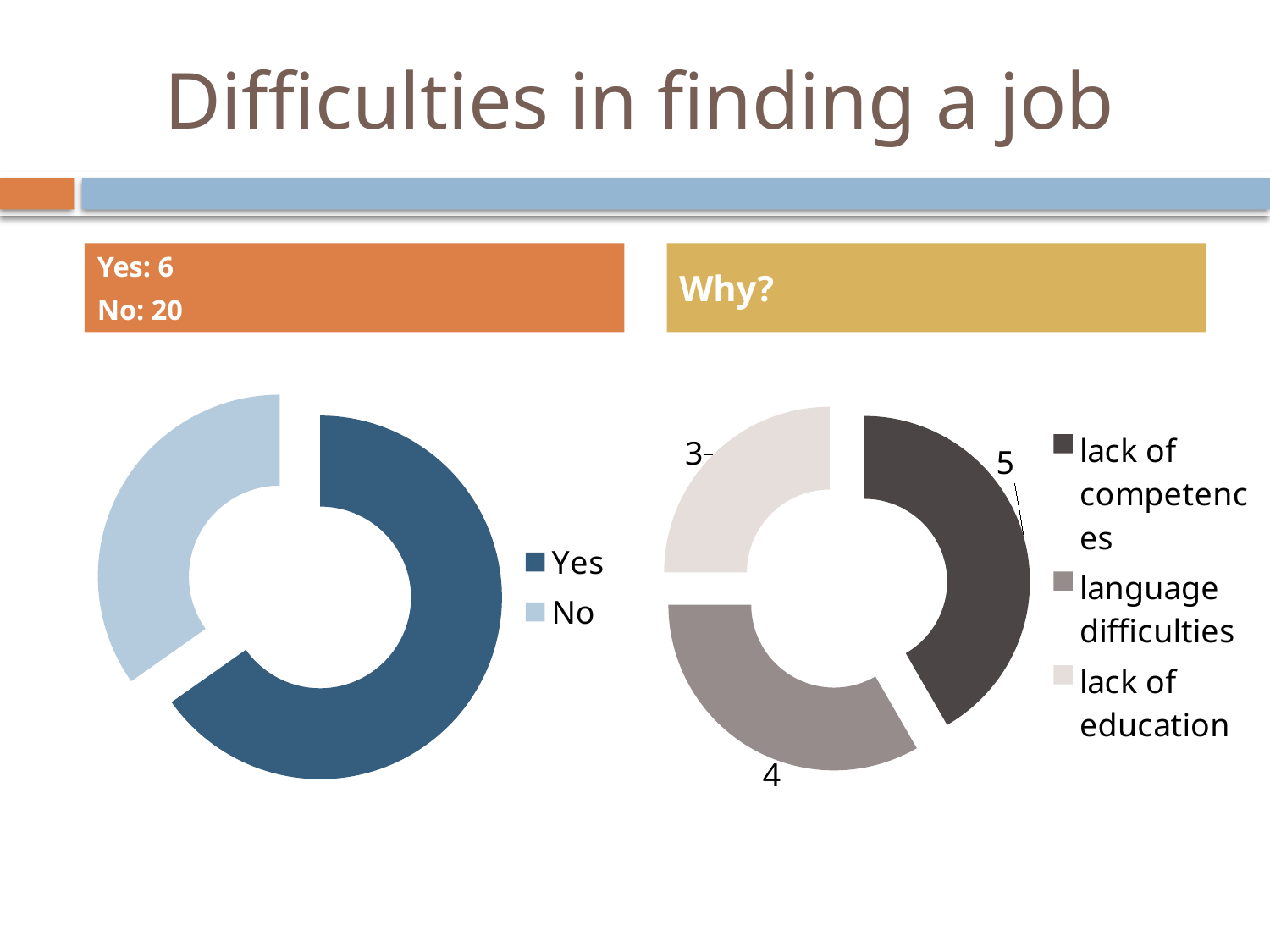
How many entries does the legend of the chart on the left list? 2 In the chart on the right, which category has the highest value? lack of competences In the chart on the right, which category has the lowest value? lack of education In the chart on the right, which is larger: language difficulties or lack of education? language difficulties In the chart on the right, what is the value for language difficulties? 4 In the chart on the right, what is the difference between the values for lack of competences and lack of education? 2 In the chart on the right, what is the value for lack of competences? 5 In the chart on the right, what is the value for lack of education? 3 What kind of chart is the chart on the right, under the "Why?" heading? Doughnut chart What is the title of the slide? Difficulties in finding a job How many categories does the chart on the right show? 3 In the chart on the right, what is the total of all three values? 12